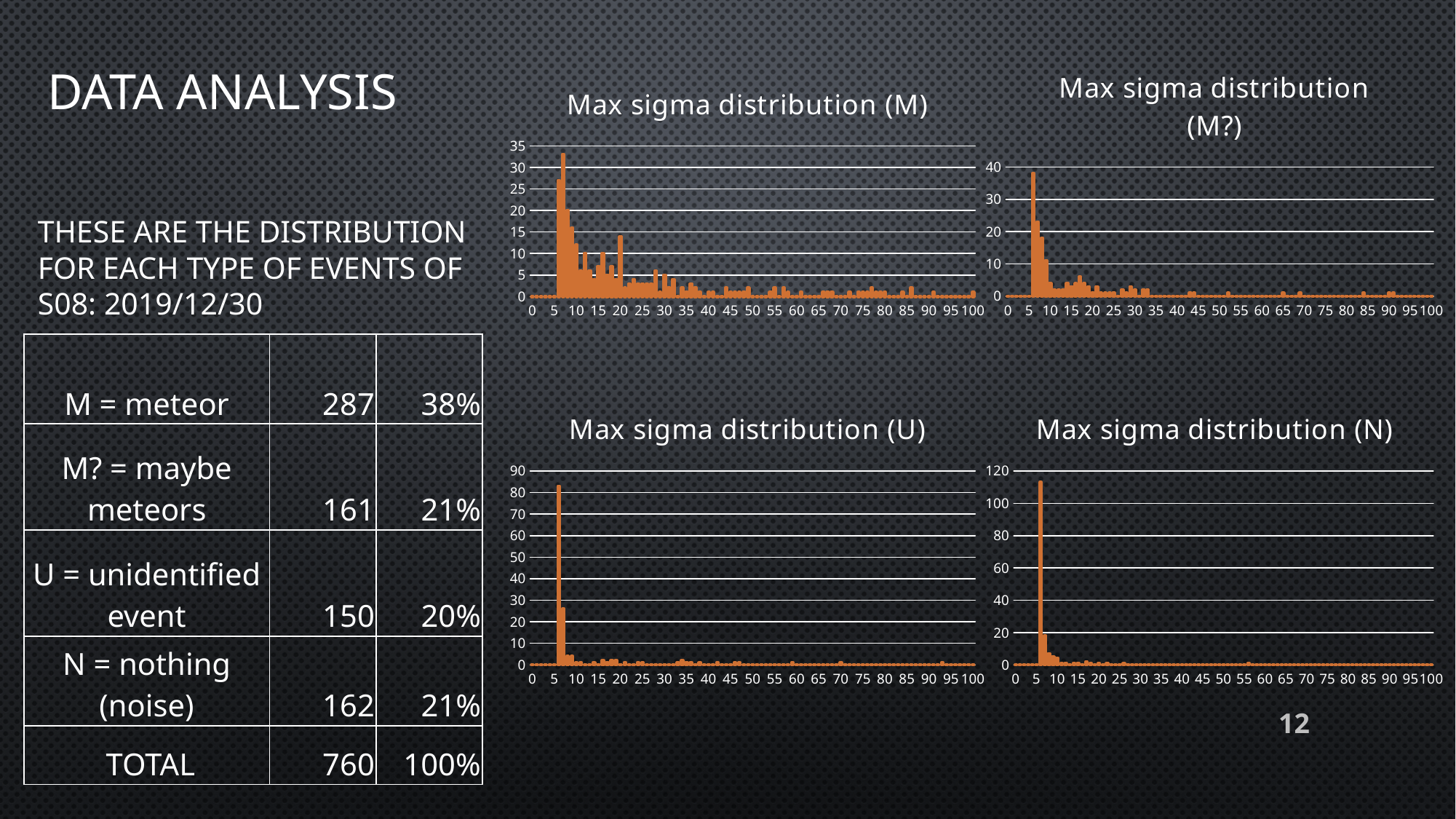
What is the highest value shown on the y axis of "Max sigma distribution (U)"? 90 In "Max sigma distribution (N)", is the value at x = 60 greater or less than 20? less In "Max sigma distribution (M?)", is the tallest bar greater or less than 30? greater In "Max sigma distribution (M)", do the bar heights generally rise or fall as x increases from 10 to 100? fall What kind of chart is "Max sigma distribution (M)"? bar chart In "Max sigma distribution (U)", is the tallest bar greater or less than 80? greater What kind of chart is "Max sigma distribution (N)"? bar chart What is the highest value shown on the y axis of "Max sigma distribution (N)"? 120 In "Max sigma distribution (N)", do the bar heights generally rise or fall as x increases from 10 to 100? fall